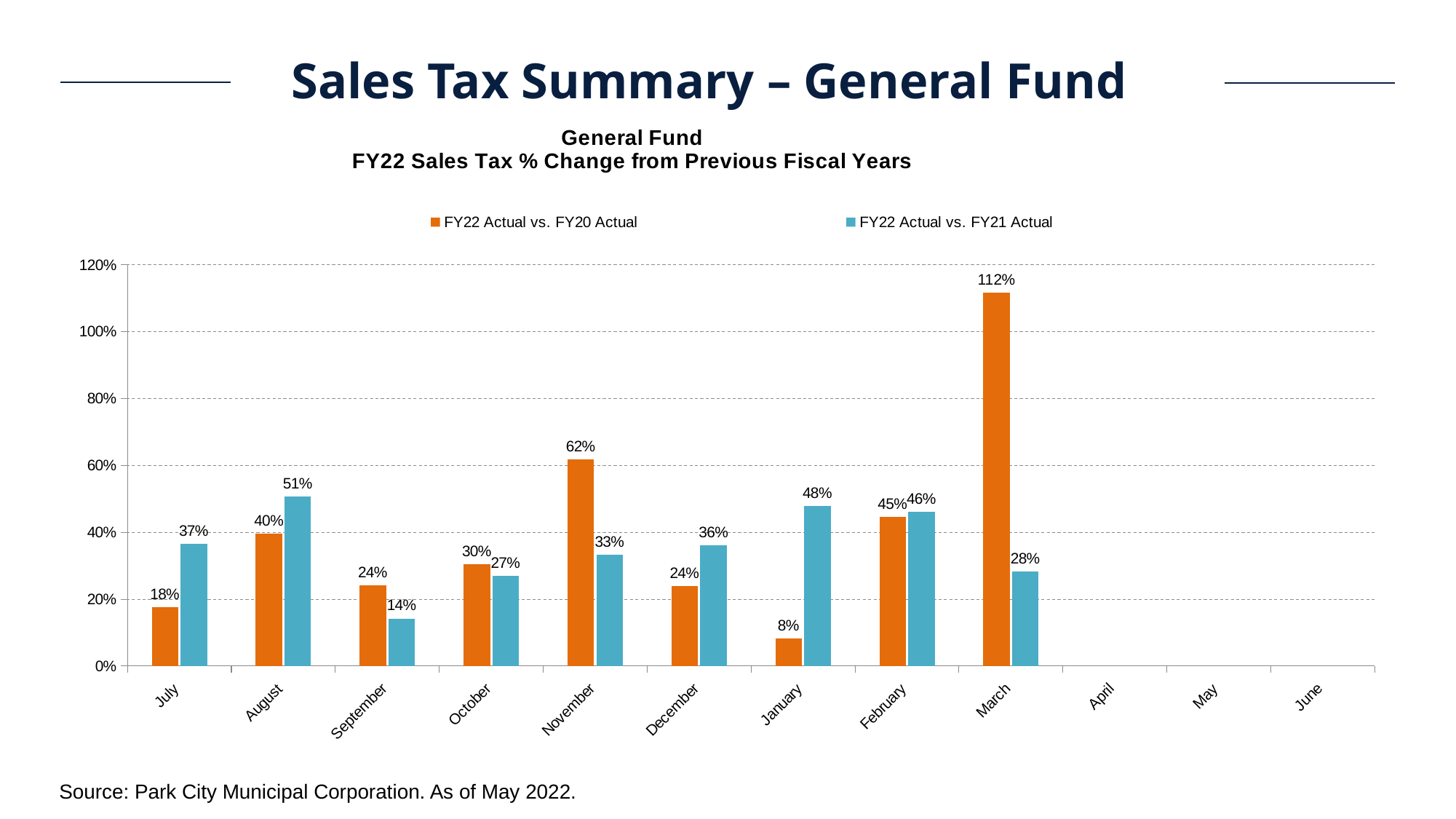
How many series does the legend list? 2 What is the FY22 Actual vs. FY20 Actual value for March? 112% How many months have data bars plotted in the chart? 9 Which month has the lowest FY22 Actual vs. FY21 Actual value? September What colour represents the FY22 Actual vs. FY21 Actual series? Blue What is the FY22 Actual vs. FY20 Actual value for January? 8% What kind of chart is shown on the slide? Bar chart What is the difference between the FY22 Actual vs. FY20 Actual and FY22 Actual vs. FY21 Actual values for March? 84% Which month has the highest FY22 Actual vs. FY20 Actual value? March Is the FY22 Actual vs. FY20 Actual value for March greater or less than 100%? greater For November, which is larger: FY22 Actual vs. FY20 Actual or FY22 Actual vs. FY21 Actual? FY22 Actual vs. FY20 Actual What is the FY22 Actual vs. FY21 Actual value for August? 51%